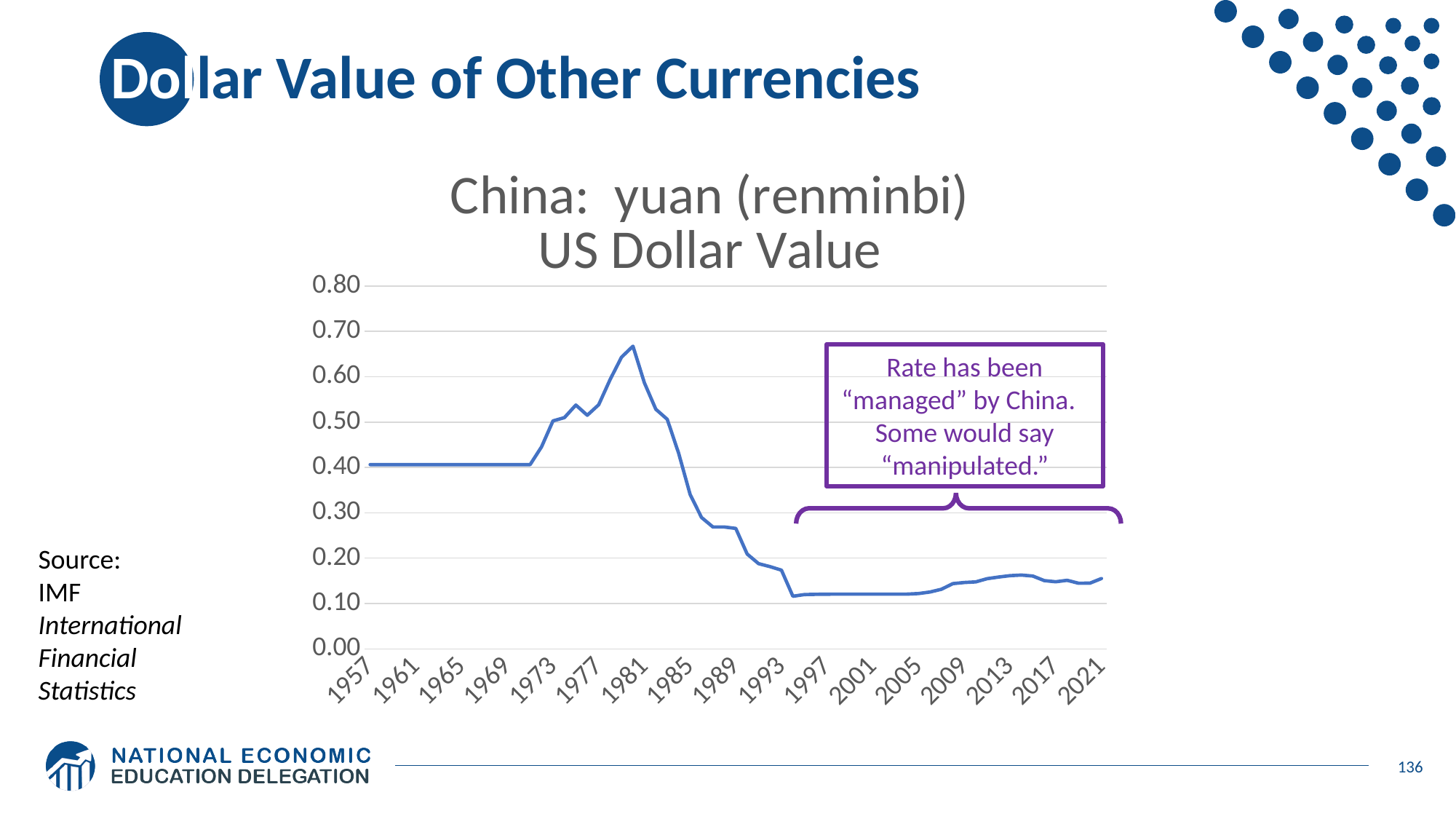
Is the value for 1957 greater or less than 0.50? less Which year has the larger value, 1981 or 2021? 1981 Do the values rise or fall between 1981 and 1993? fall Is the value for 2021 greater or less than 0.20? less How many year labels are shown on the x axis? 17 What is the title of the chart? China: yuan (renminbi) US Dollar Value What kind of chart is shown on the slide? line chart Which year has the larger value, 1957 or 2001? 1957 Do the values rise or fall between 1969 and 1981? rise Is the value for 1997 greater or less than 0.20? less